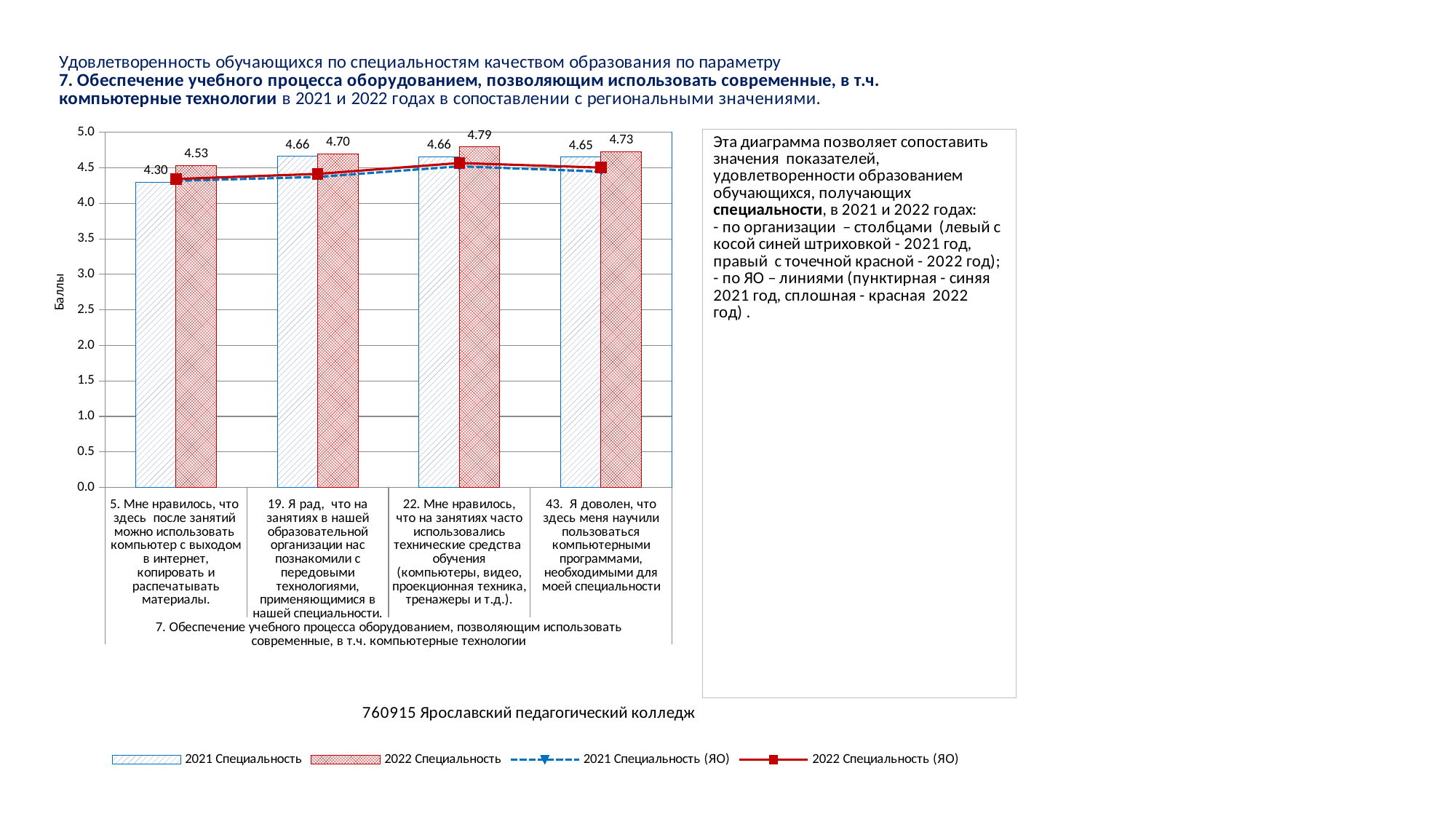
Сколько серий перечислено в легенде диаграммы? 4 Какое значение показано для серии «2022 Специальность» по утверждению 22 («Мне нравилось, что на занятиях часто использовались технические средства обучения...»)? 4.79 Какая подпись указана у вертикальной оси диаграммы? Баллы Сколько категорий (утверждений) показано по оси X диаграммы? 4 Какое значение больше: «2022 Специальность» по утверждению 22 или «2022 Специальность» по утверждению 43? 2022 Специальность по утверждению 22 (4.79) Какое значение показано для серии «2021 Специальность» по утверждению 19 («Я рад, что на занятиях в нашей образовательной организации нас познакомили с передовыми технологиями...»)? 4.66 По какому утверждению значение серии «2022 Специальность» самое высокое? 22. Мне нравилось, что на занятиях часто использовались технические средства обучения Какое значение показано для серии «2022 Специальность» по утверждению 43 («Я доволен, что здесь меня научили пользоваться компьютерными программами...»)? 4.73 На сколько значение серии «2022 Специальность» по утверждению 5 больше значения серии «2021 Специальность» по тому же утверждению? 0.23 Какое значение показано для серии «2021 Специальность» по утверждению 5 («Мне нравилось, что здесь после занятий можно использовать компьютер с выходом в интернет...»)? 4.30 Значение линии «2022 Специальность (ЯО)» по утверждению 5 больше или меньше 4.0? больше По какому утверждению значение серии «2021 Специальность» самое низкое? 5. Мне нравилось, что здесь после занятий можно использовать компьютер с выходом в интернет